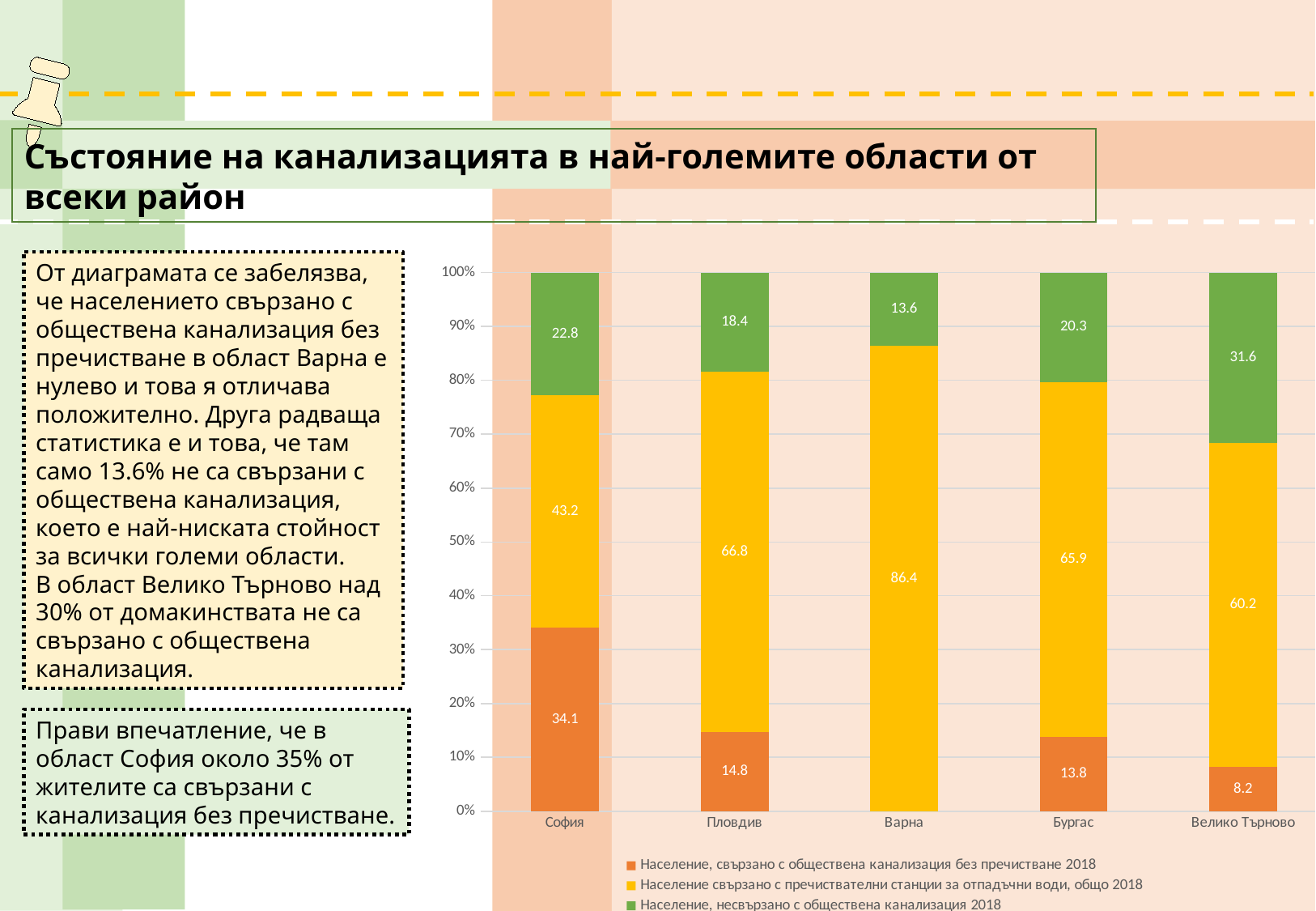
How many series does the chart legend list? 3 How many regions (categories) are shown on the x axis of the chart? 5 What is the value of the yellow segment (население свързано с пречиствателни станции за отпадъчни води, общо 2018) for Варна? 86.4 Which region has no orange segment (население, свързано с обществена канализация без пречистване 2018) in the chart? Варна What is the difference between the yellow segment values for Пловдив and Бургас? 0.9 Which region has the highest value for the green series (население, несвързано с обществена канализация 2018)? Велико Търново What is the value of the green segment (население, несвързано с обществена канализация 2018) for Велико Търново? 31.6 Which is larger: the orange segment for Пловдив or the orange segment for Бургас? Пловдив What type of chart is shown on the slide? stacked bar chart Which region has the lowest value for the green series (население, несвързано с обществена канализация 2018)? Варна Which region has the highest value for the orange series (население, свързано с обществена канализация без пречистване 2018)? София What is the value of the orange segment (население, свързано с обществена канализация без пречистване 2018) for София? 34.1